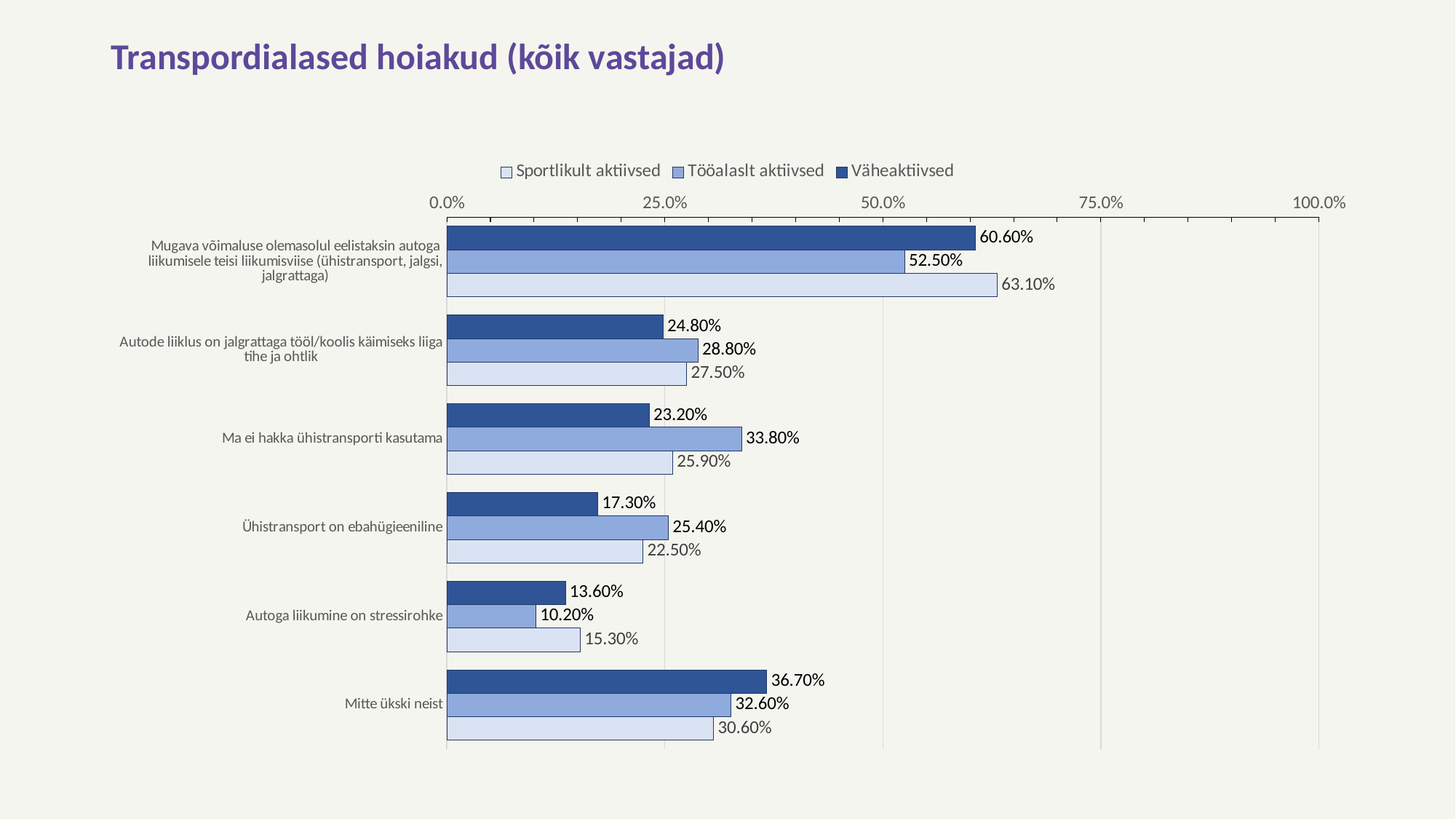
What is the value for Tööalaslt aktiivsed for "Ma ei hakka ühistransporti kasutama"? 33.80% What is the value for Sportlikult aktiivsed for "Autoga liikumine on stressirohke"? 15.30% Which category has the lowest value for Tööalaslt aktiivsed? Autoga liikumine on stressirohke What is the difference between the Sportlikult aktiivsed and Tööalaslt aktiivsed values for "Mugava võimaluse olemasolul eelistaksin autoga liikumisele teisi liikumisviise"? 10.60% What is the value for Väheaktiivsed for "Mitte ükski neist"? 36.70% Which category has the highest value for Sportlikult aktiivsed? Mugava võimaluse olemasolul eelistaksin autoga liikumisele teisi liikumisviise (ühistransport, jalgsi, jalgrattaga) How many categories are shown on the chart? 6 For "Ühistransport on ebahügieeniline", which is larger: the Väheaktiivsed value or the Tööalaslt aktiivsed value? Tööalaslt aktiivsed What kind of chart is shown on the slide? Bar chart What is the title of the slide? Transpordialased hoiakud (kõik vastajad) Is the Väheaktiivsed value for "Mugava võimaluse olemasolul eelistaksin autoga liikumisele teisi liikumisviise" greater or less than 50.0%? greater How many series does the legend list? 3